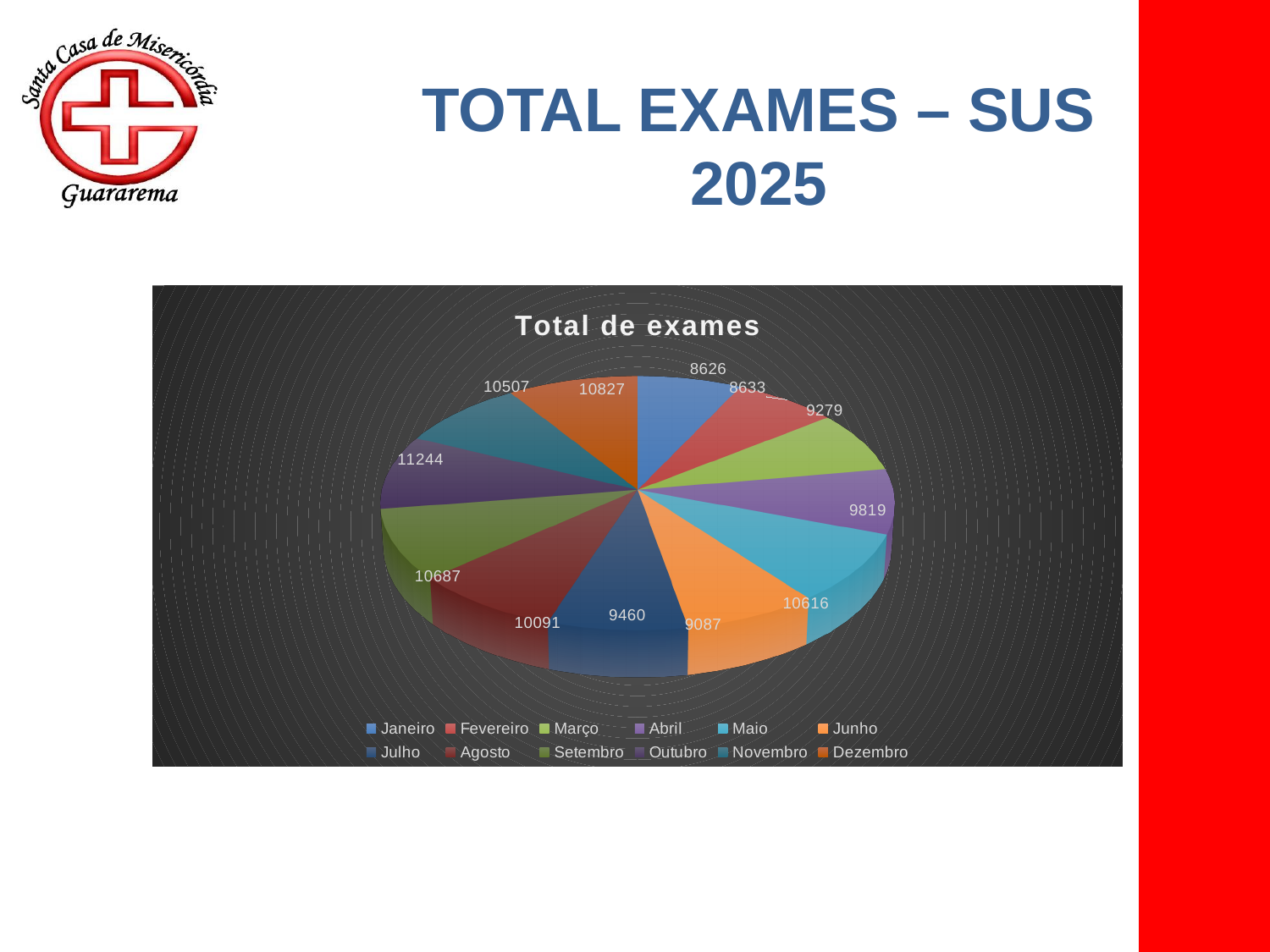
What is the title of the chart? Total de exames Which month is shown in the legend immediately after Junho? Julho What is the value for Maio? 10616 How many slices (months) does the pie chart have? 12 What is the difference between the values for Maio and Junho? 1529 What is the value for Julho? 9460 What is the value for Outubro? 11244 What type of chart is shown on the slide? Pie chart What is the difference between the values for Outubro and Janeiro? 2618 Which month has the lowest total of exams? Janeiro Which is larger, the value for Setembro or the value for Agosto? Setembro Which month has the highest total of exams? Outubro